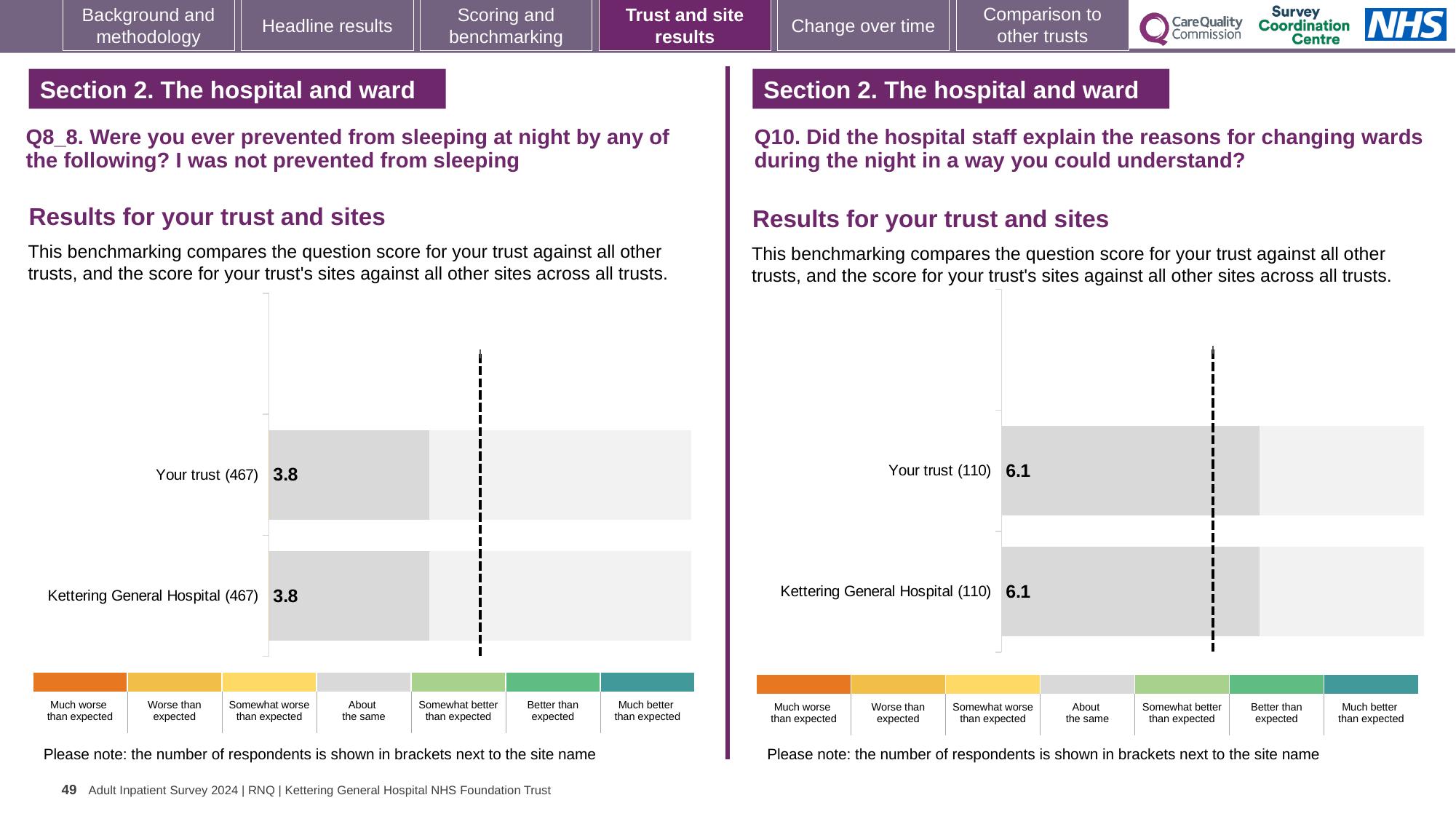
How many bars are plotted on the left chart (Q8_8)? 2 How many bars are plotted on the right chart (Q10)? 2 On the left chart (Q8_8), what is the difference between the score for Your trust and the score for Kettering General Hospital? 0 On the left chart (Q8_8), what is the score for Your trust? 3.8 Is the score for Your trust on the right chart (Q10) larger than the score for Your trust on the left chart (Q8_8)? Yes What kind of chart is used on the left (Q8_8)? Bar chart On the left chart (Q8_8), how many respondents are shown in brackets next to Your trust? 467 On the right chart (Q10), what is the difference between the score for Your trust and the score for Kettering General Hospital? 0 On the right chart (Q10), how many respondents are shown in brackets next to Kettering General Hospital? 110 On the right chart (Q10), what is the score for Your trust? 6.1 On the left chart (Q8_8), what is the score for Kettering General Hospital? 3.8 On the right chart (Q10), what is the score for Kettering General Hospital? 6.1